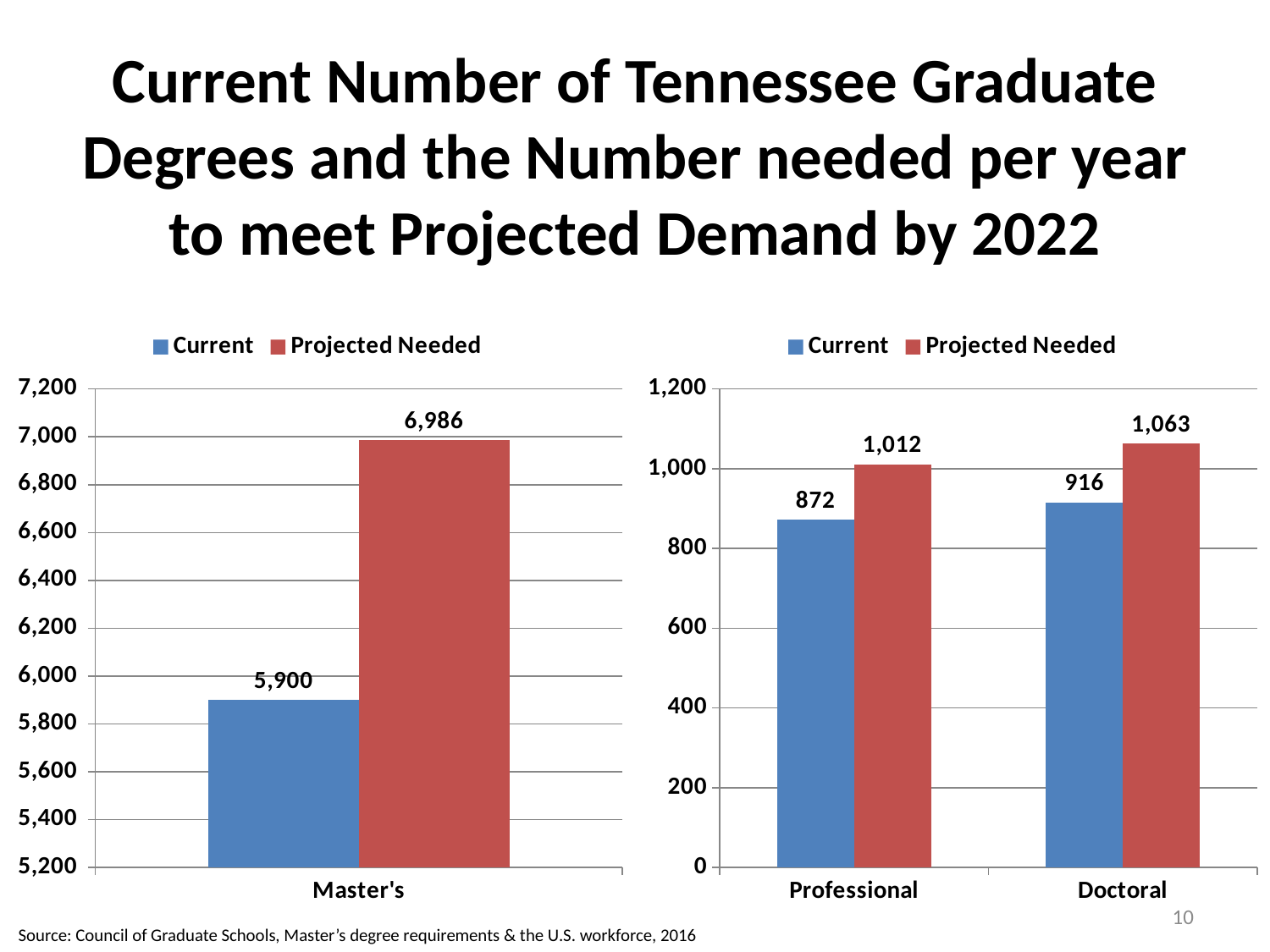
In the right chart, which category has the lowest Current value? Professional In the right chart, which category has the highest Projected Needed value? Doctoral How many series does the legend of the left chart list? 2 How many categories are shown on the x axis of the right chart? 2 In the left chart, what is the Projected Needed value for Master's? 6,986 In the right chart, what is the Current value for Professional? 872 In the right chart, is the Current value for Doctoral larger or smaller than the Projected Needed value for Professional? smaller In the left chart, what is the difference between the Projected Needed and Current values for Master's? 1,086 What type of chart is the right chart? bar chart In the right chart, what is the Projected Needed value for Doctoral? 1,063 In the left chart, what is the Current value for Master's? 5,900 In the right chart, what is the difference between the Projected Needed and Current values for Professional? 140